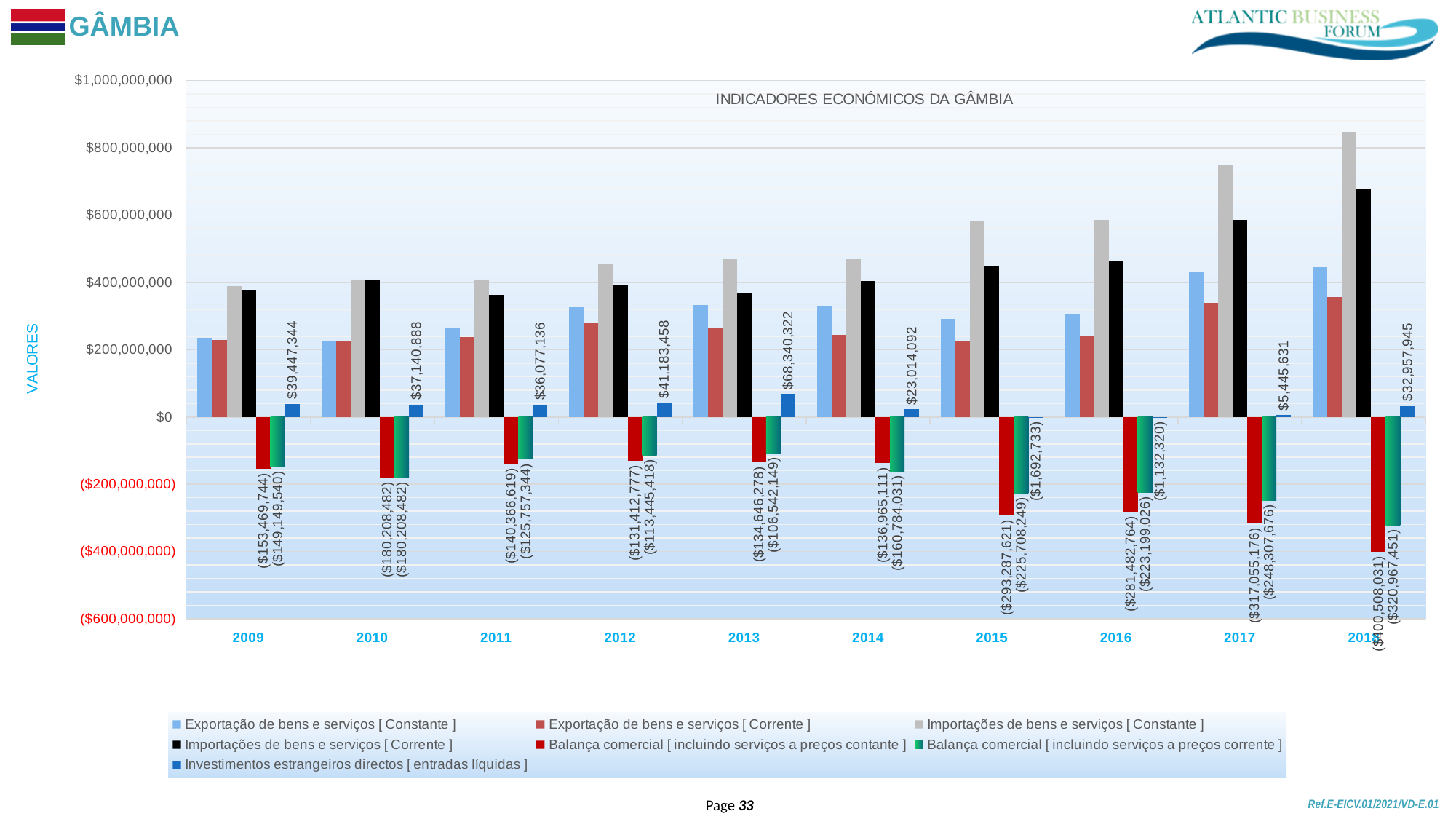
How many years are shown on the x axis of the chart? 10 What is the difference between Investimentos estrangeiros directos [ entradas líquidas ] in 2013 and in 2014? $45,326,230 In which year is Investimentos estrangeiros directos [ entradas líquidas ] highest? 2013 Is the value for Importações de bens e serviços [ Constante ] in 2018 greater or less than $800,000,000? greater What is the value of Investimentos estrangeiros directos [ entradas líquidas ] in 2013? $68,340,322 Which year has the larger value for Investimentos estrangeiros directos [ entradas líquidas ], 2009 or 2010? 2009 What is the value of Balança comercial [ incluindo serviços a preços corrente ] in 2013? ($106,542,149) What kind of chart is shown on the slide? Bar chart What is the title of the chart? INDICADORES ECONÓMICOS DA GÂMBIA How many series does the legend list? 7 What is the value of Balança comercial [ incluindo serviços a preços contante ] in 2018? ($400,508,031) In which year is Investimentos estrangeiros directos [ entradas líquidas ] lowest? 2015